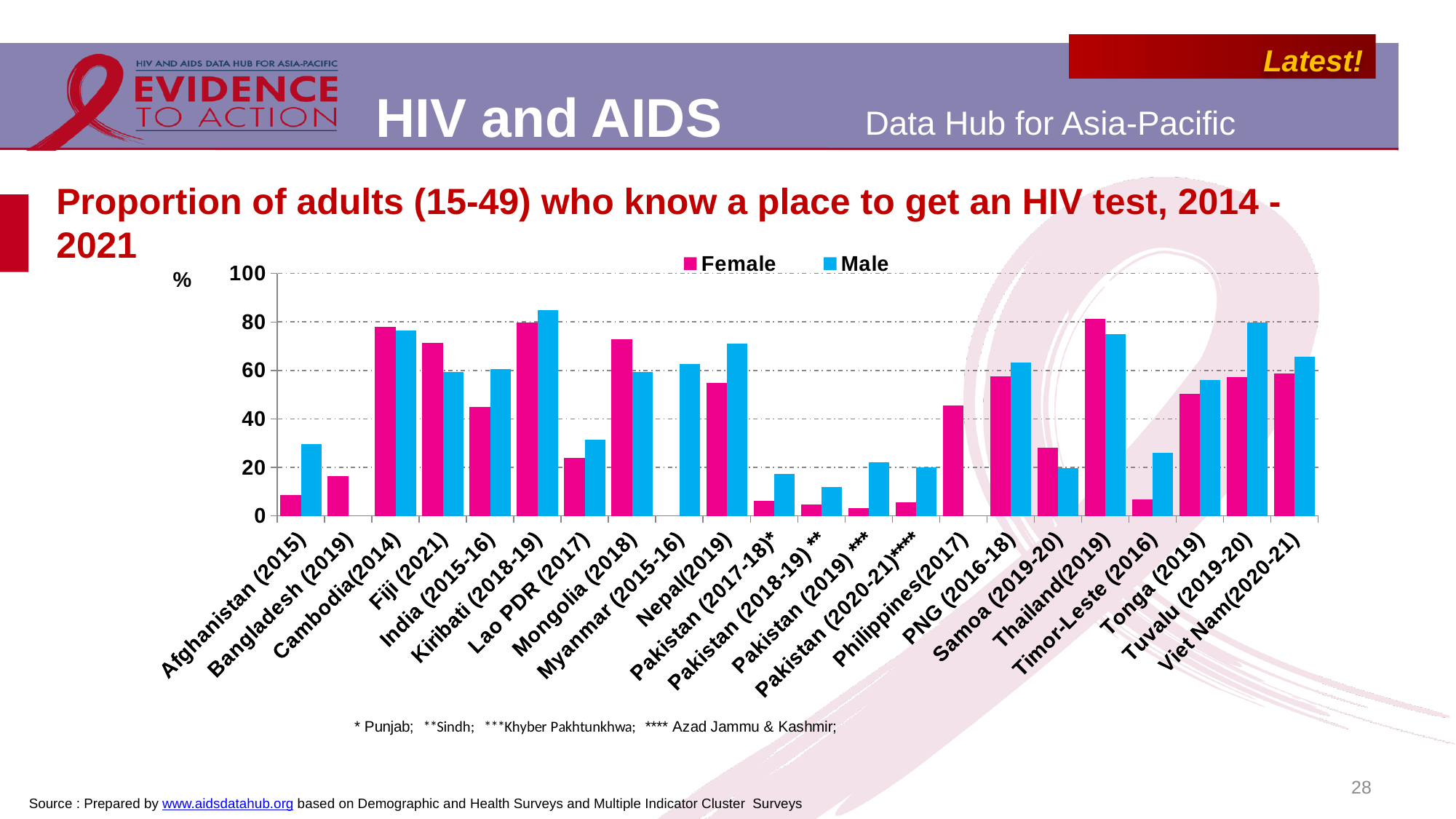
Which colour represents the Male series in the chart? blue How many country/survey categories are shown on the x axis? 22 Is the Male value for Thailand(2019) greater or less than 60? greater Is the Female value for Cambodia(2014) greater or less than 60? greater How many series does the legend list? 2 Is the Female value for Timor-Leste (2016) greater or less than 20? less For Mongolia (2018), which is larger, the Female or the Male value? Female For Afghanistan (2015), which is larger, the Female or the Male value? Male For Fiji (2021), which is larger, the Female or the Male value? Female What kind of chart is shown on the slide? bar chart